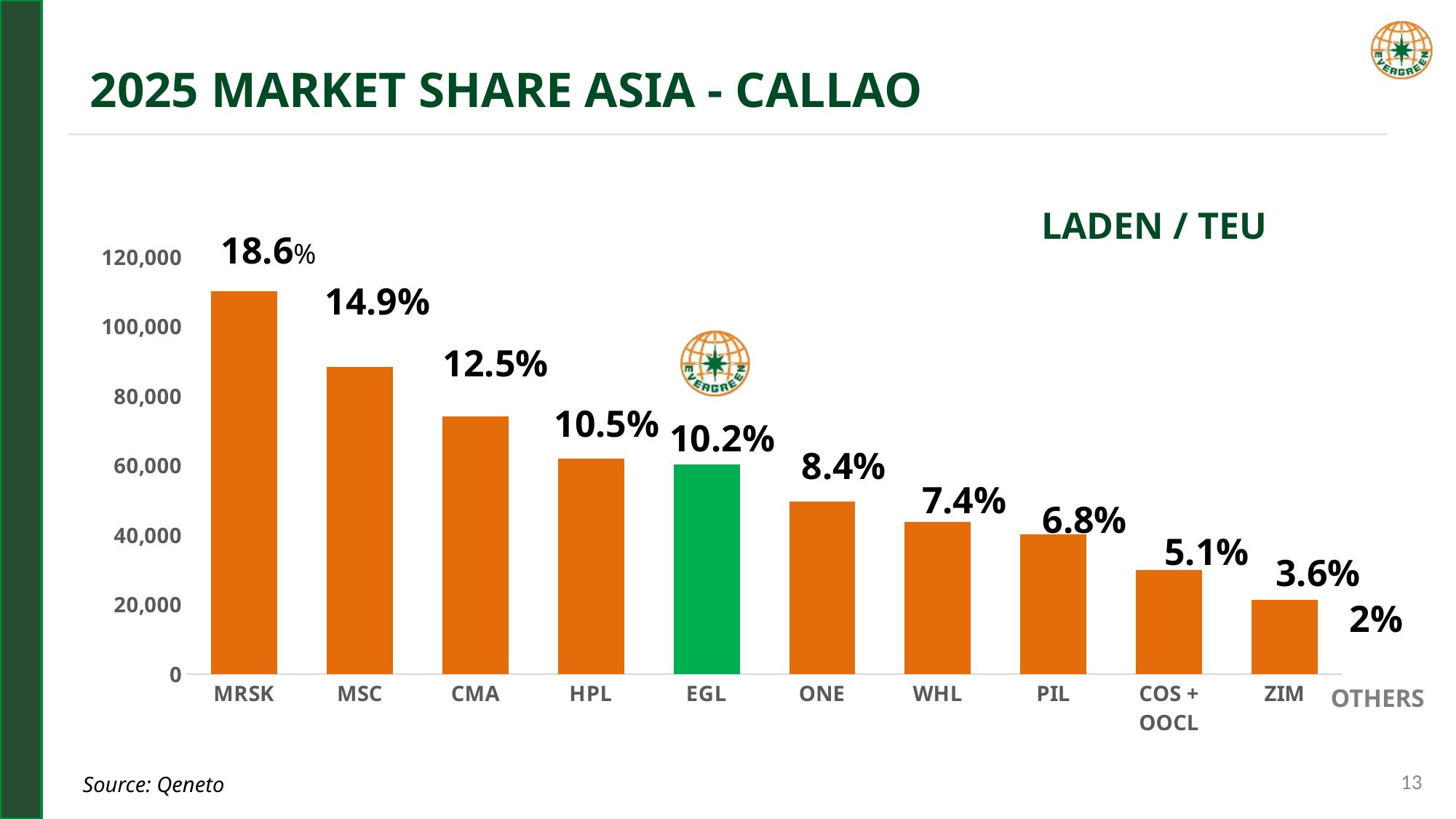
What is the difference in market share between MRSK and MSC? 3.7 percentage points What market share percentage is shown for EGL? 10.2% What market share percentage is shown for MRSK? 18.6% Which carrier's bar is coloured green instead of orange? EGL Which carrier has the highest market share? MRSK Which carrier has the lowest market share among the plotted bars? ZIM What market share percentage is shown for COS + OOCL? 5.1% Which has a larger market share, HPL or ONE? HPL Is the value for CMA greater or less than 80,000? less What market share percentage is shown for OTHERS? 2% What kind of chart is shown on the slide? Bar chart Is the value for MRSK greater or less than 100,000? greater